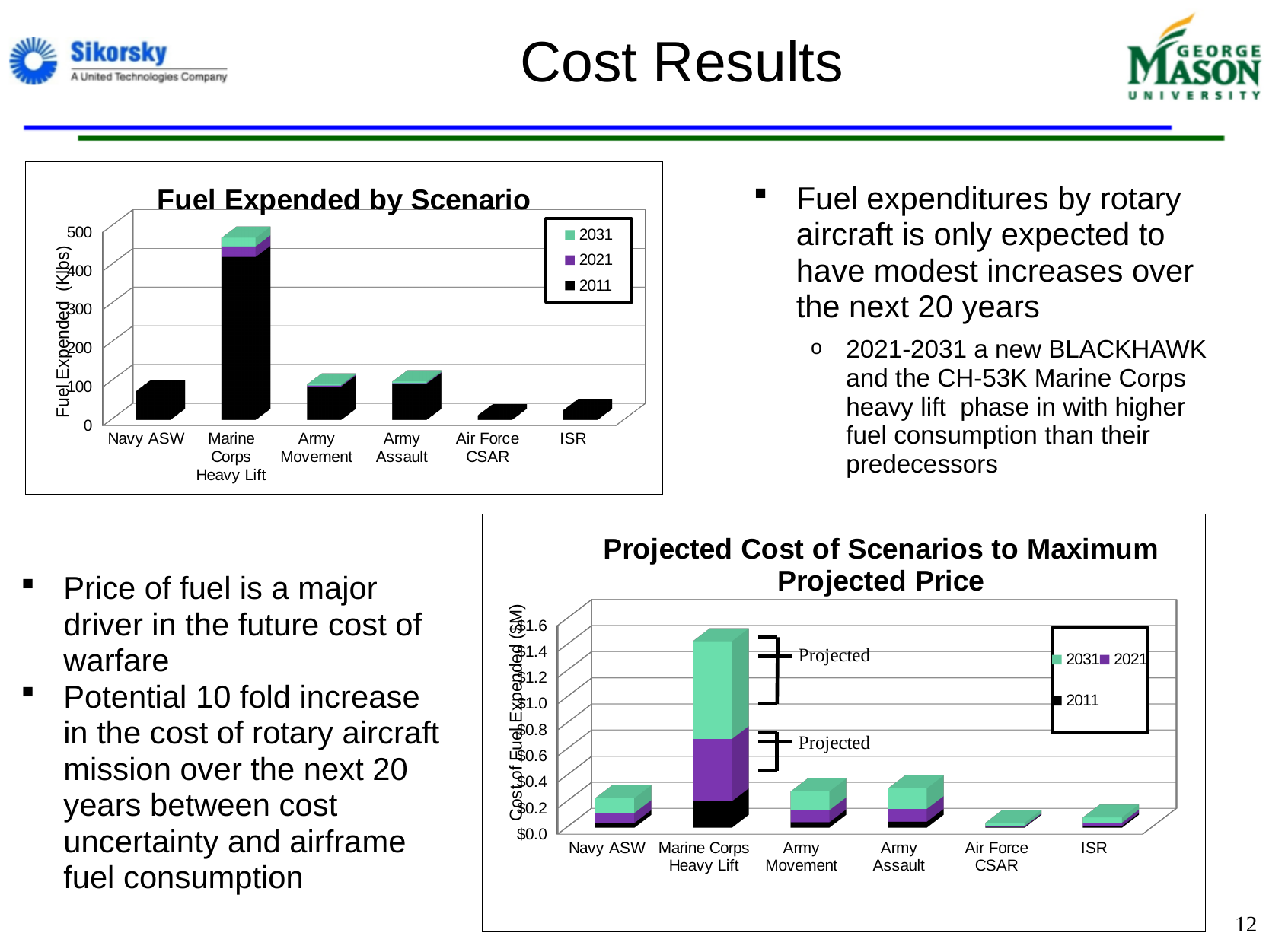
In the "Projected Cost of Scenarios to Maximum Projected Price" chart, is the total value for Marine Corps Heavy Lift greater or less than $1.0? greater In the "Projected Cost of Scenarios to Maximum Projected Price" chart, which scenario has the highest total cost? Marine Corps Heavy Lift How many scenarios are shown on the x axis of the "Fuel Expended by Scenario" chart? 6 What is the y-axis label of the "Fuel Expended by Scenario" chart? Fuel Expended (Klbs) In the "Fuel Expended by Scenario" chart, which scenario has the highest total fuel expended? Marine Corps Heavy Lift What type of chart is the "Fuel Expended by Scenario" chart? stacked bar chart In the "Fuel Expended by Scenario" chart, is the total value for Marine Corps Heavy Lift greater or less than 400? greater In the "Fuel Expended by Scenario" chart, is the value for Air Force CSAR greater or less than 100? less How many series does the legend of the "Fuel Expended by Scenario" chart list? 3 In the "Fuel Expended by Scenario" chart, which is larger, the total for Navy ASW or the total for Marine Corps Heavy Lift? Marine Corps Heavy Lift Which years are listed in the legend of the "Projected Cost of Scenarios to Maximum Projected Price" chart? 2031, 2021, 2011 In the "Projected Cost of Scenarios to Maximum Projected Price" chart, which scenario has the lowest total cost? Air Force CSAR